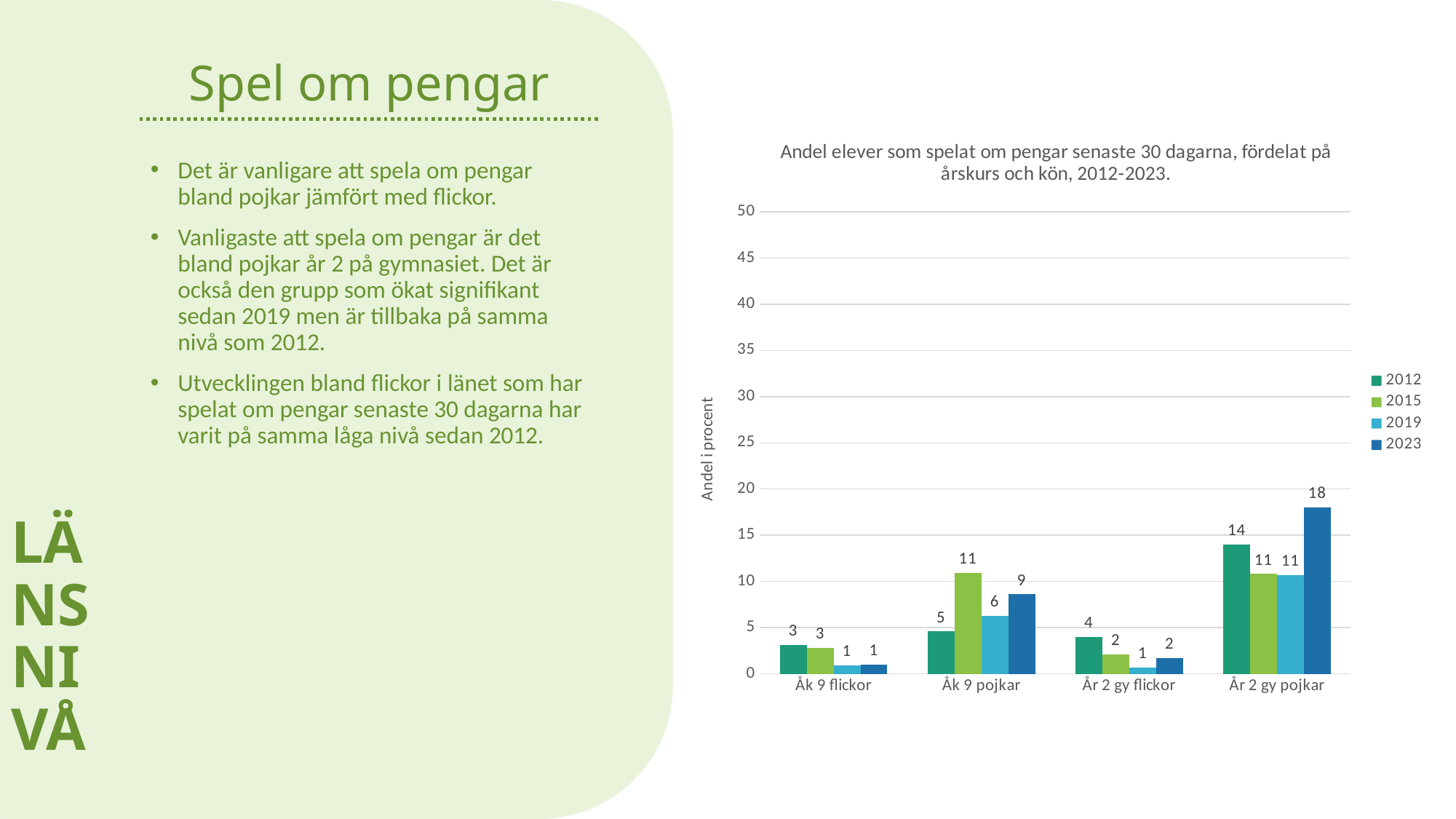
Is the value for År 2 gy pojkar in 2012 greater or less than 10? greater What is the difference between the 2023 and 2019 values for År 2 gy pojkar? 7 Which is larger for Åk 9 pojkar: the 2015 value or the 2023 value? 2015 What is the label of the y axis? Andel i procent What is the value for Åk 9 pojkar in 2015? 11 How many series does the legend list? 4 Which category has the highest value in 2023? År 2 gy pojkar What is the value for År 2 gy pojkar in 2023? 18 What is the value for År 2 gy flickor in 2012? 4 What kind of chart is shown on the slide? Bar chart How many categories are shown on the x axis? 4